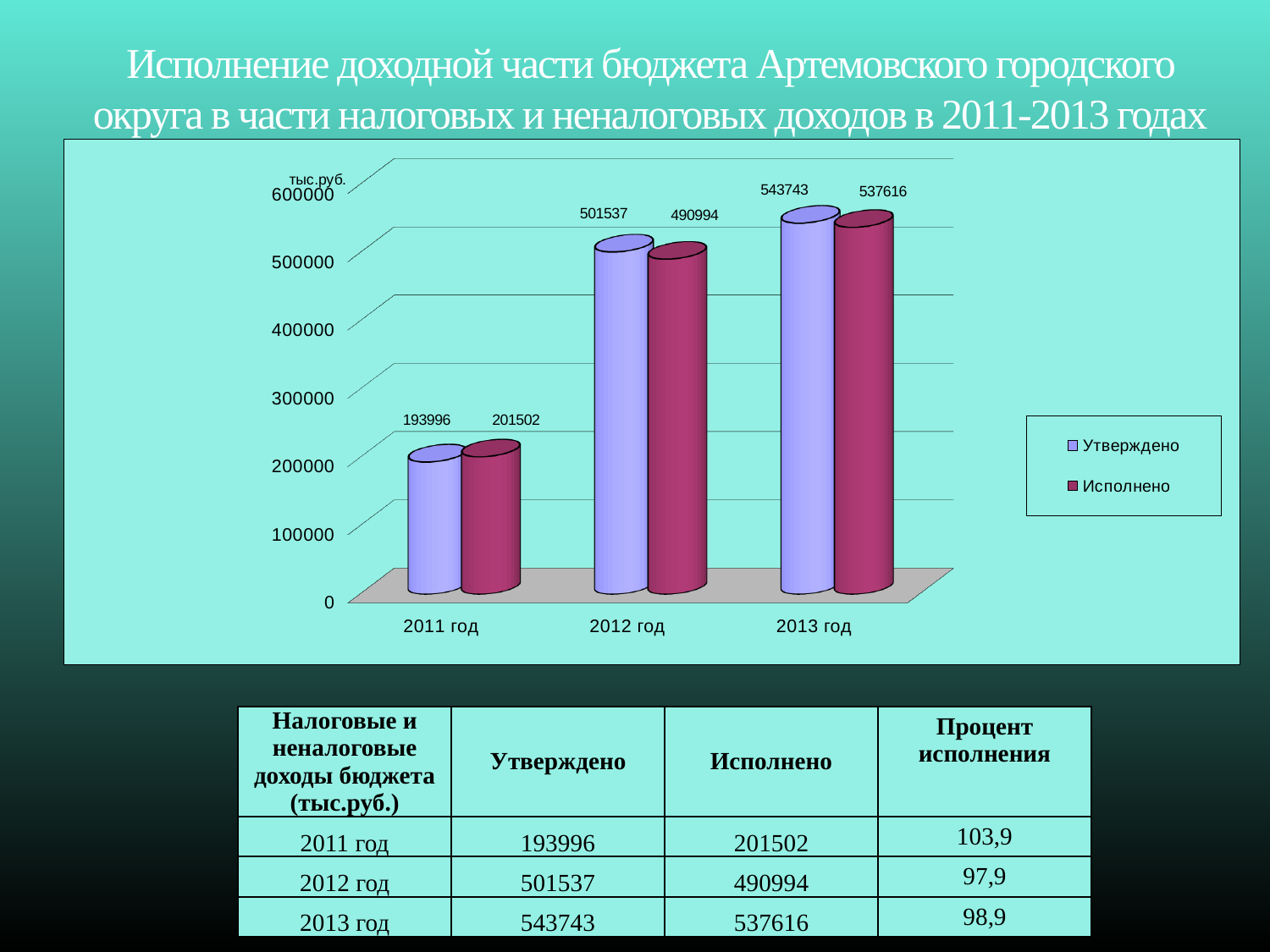
What is the difference between Исполнено and Утверждено for 2011 год? 7506 What is the value of Исполнено for 2013 год? 537616 What is the difference between Утверждено and Исполнено for 2012 год? 10543 Does the Утверждено value rise or fall from 2011 год to 2013 год? rise What is the value of Утверждено for 2011 год? 193996 Which year has the lowest Исполнено value? 2011 год What is the value of Исполнено for 2012 год? 490994 How many series does the chart legend list? 2 How many years are shown on the x axis of the chart? 3 Which is larger for 2011 год, Утверждено or Исполнено? Исполнено Which is larger for 2013 год, Утверждено or Исполнено? Утверждено Which year has the highest Утверждено value? 2013 год